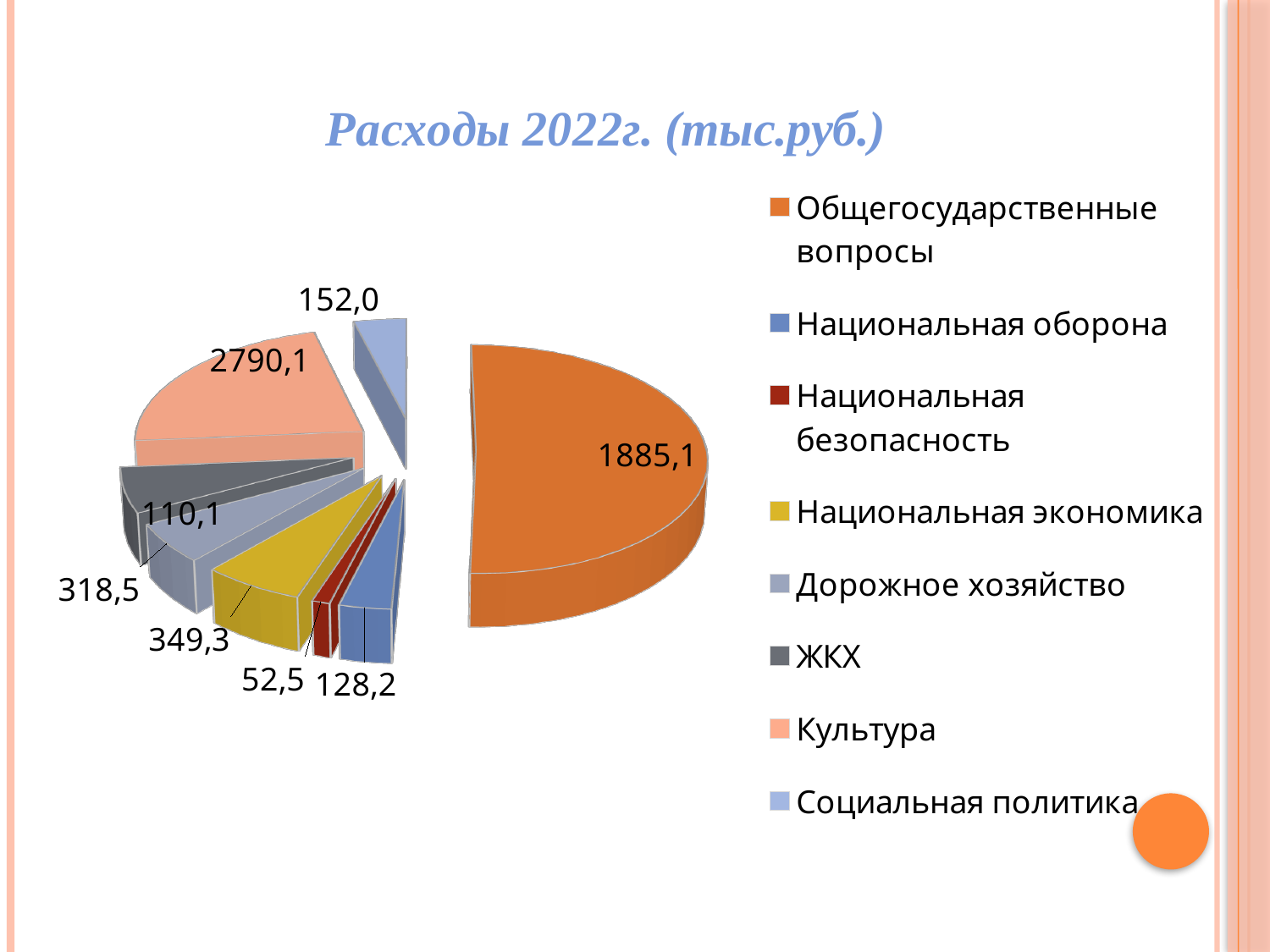
What is the difference between the values for Социальная политика and Национальная оборона? 23,8 What is the difference between the values for Культура and Общегосударственные вопросы? 905,0 What is the title of the chart? Расходы 2022г. (тыс.руб.) Which category has the smallest value? Национальная безопасность What is the value for Дорожное хозяйство? 318,5 What is the value for Общегосударственные вопросы? 1885,1 What is the value for Культура? 2790,1 How many categories does the legend list? 8 What is the value for Национальная безопасность? 52,5 Which is larger, the value for Национальная экономика or the value for Дорожное хозяйство? Национальная экономика What kind of chart is shown on the slide? pie chart Which category has the largest value? Культура